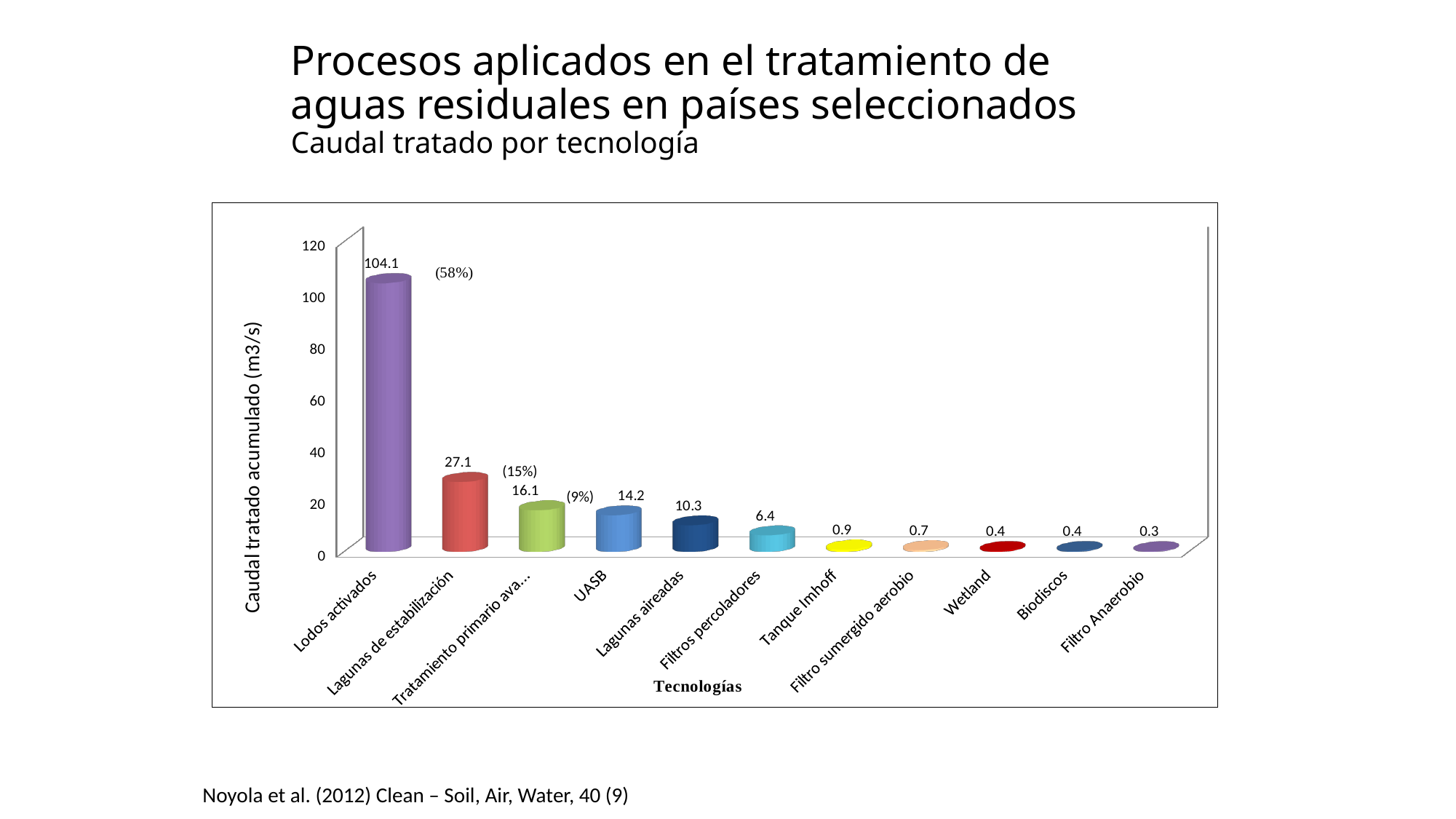
What is the value for UASB? 14.2 How many technologies are shown on the x axis? 11 What is the label of the y axis? Caudal tratado acumulado (m3/s) What is the difference between the values for Lagunas de estabilización and Lagunas aireadas? 16.8 What kind of chart is this? bar chart What is the value for Lodos activados? 104.1 Which technology has the highest treated flow? Lodos activados What is the value for Tanque Imhoff? 0.9 What is the value for Filtros percoladores? 6.4 Which is larger, the value for UASB or the value for Tratamiento primario ava...? UASB Which technology has the lowest treated flow? Filtro Anaerobio Is the value for Lodos activados greater or less than 100? greater